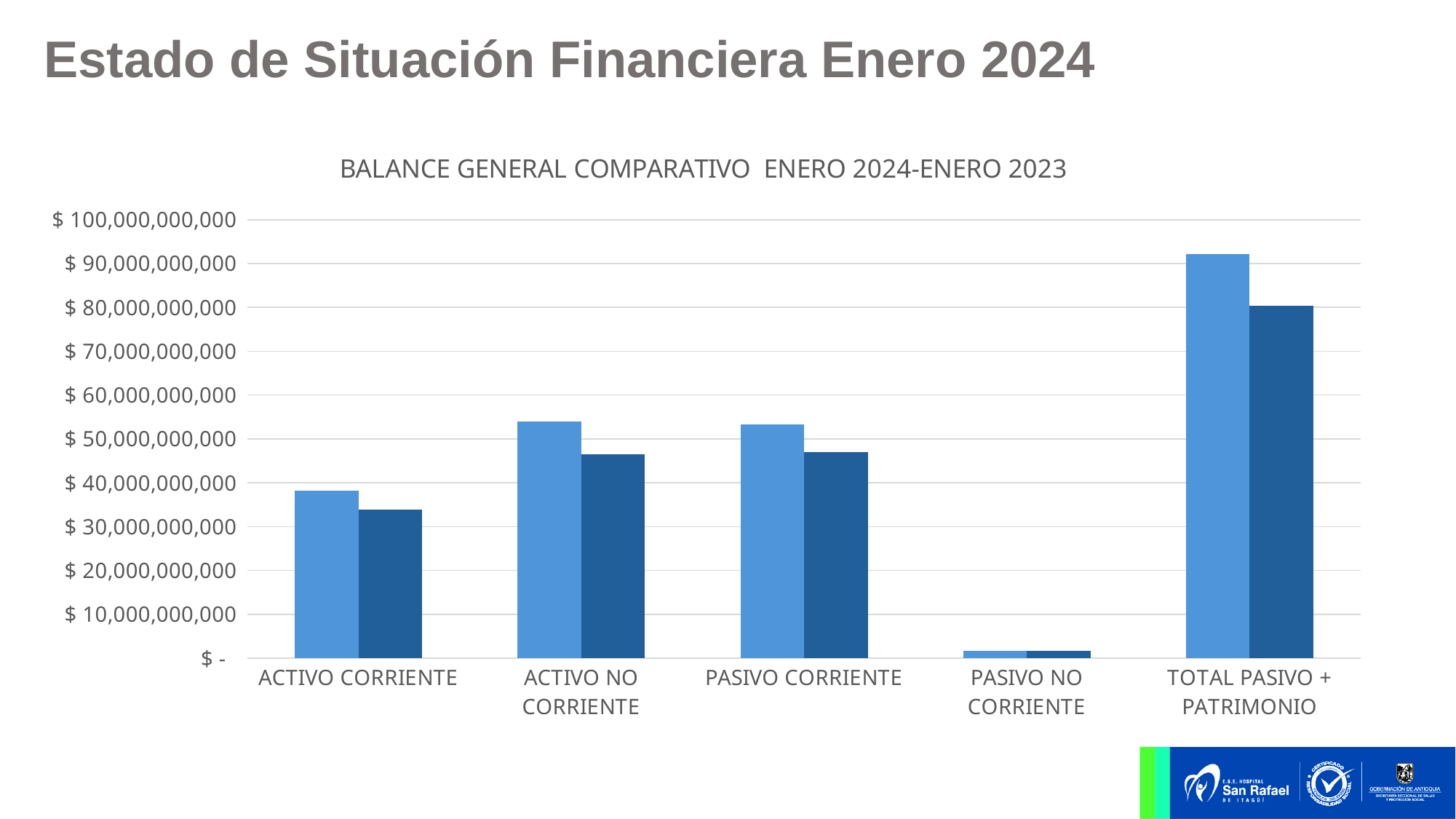
How many categories are shown on the x axis of the chart? 5 Which category has a taller light blue bar, ACTIVO CORRIENTE or PASIVO CORRIENTE? PASIVO CORRIENTE Is the light blue bar for TOTAL PASIVO + PATRIMONIO greater or less than $ 90,000,000,000? greater What is the title of the chart? BALANCE GENERAL COMPARATIVO ENERO 2024-ENERO 2023 What kind of chart is shown on the slide? bar chart For ACTIVO CORRIENTE, which bar is taller, the light blue bar or the dark blue bar? the light blue bar Which category has the lowest bars in the chart? PASIVO NO CORRIENTE Is the light blue bar for ACTIVO NO CORRIENTE greater or less than $ 50,000,000,000? greater Which category has the highest bars in the chart? TOTAL PASIVO + PATRIMONIO Is the light blue bar for ACTIVO CORRIENTE greater or less than $ 40,000,000,000? less